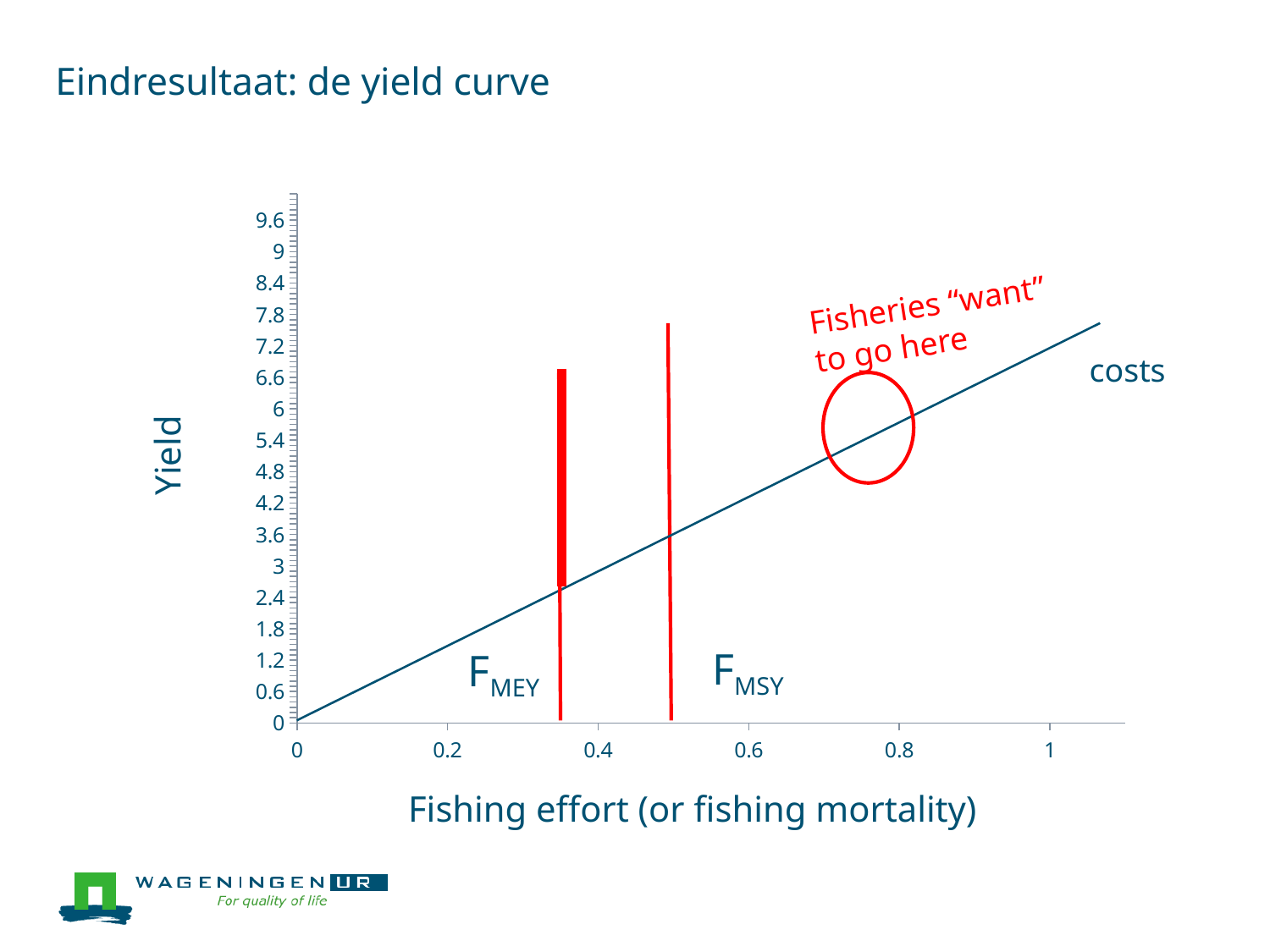
Is the value of the costs line at a fishing effort of 0.2 greater or less than 1.8? less Is the value of the costs line at a fishing effort of 0.4 greater or less than 3.6? less Is the value of the costs line at a fishing effort of 0.8 greater or less than 4.8? greater What is the label of the x axis of the chart? Fishing effort (or fishing mortality) Does the costs line rise or fall as fishing effort increases along the x axis? rises What label is written next to the straight line plotted on the chart? costs What kind of chart is shown on the slide? line chart